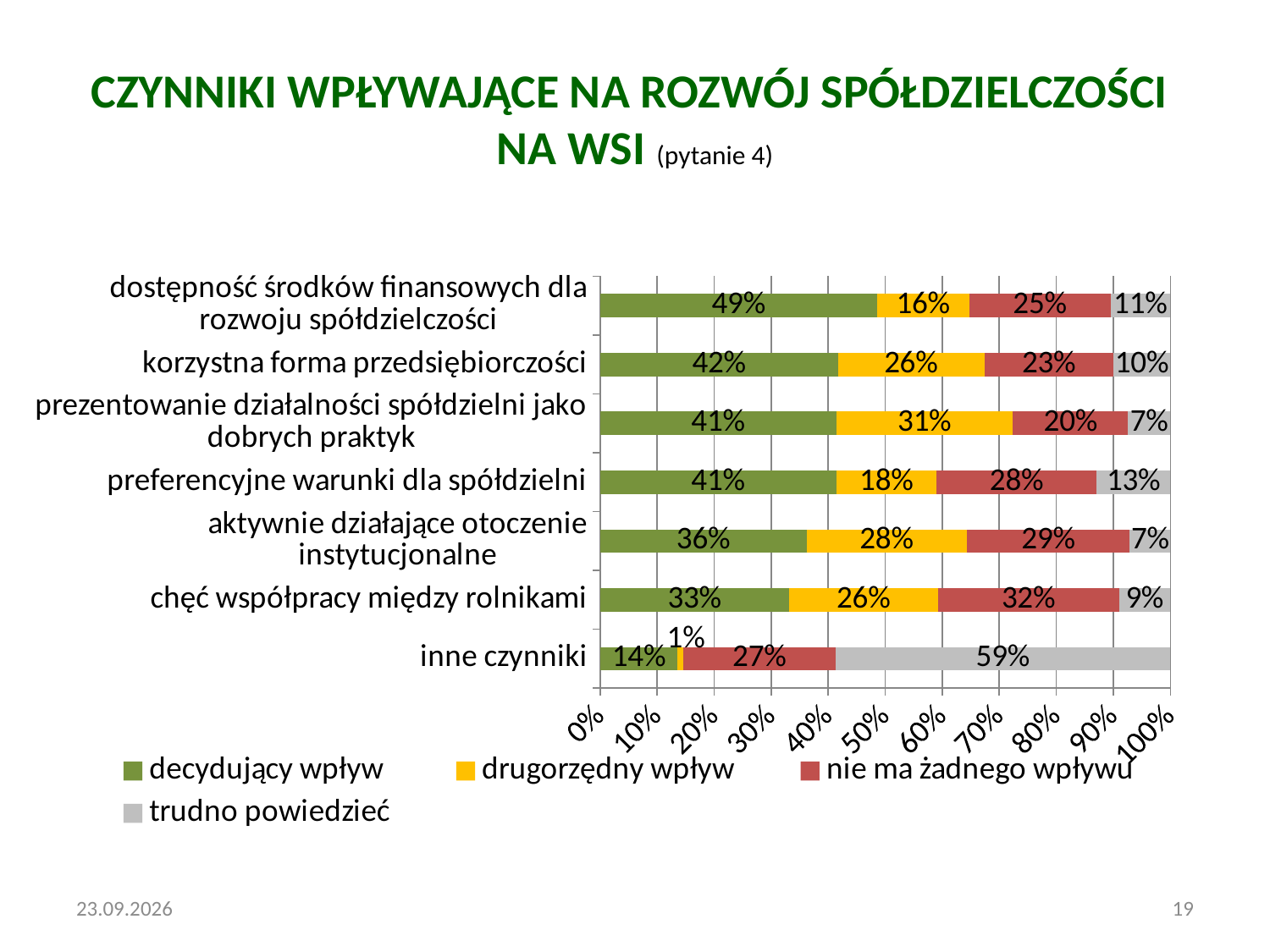
What kind of chart is shown on the slide? stacked bar chart Which category has the highest value for 'decydujący wpływ'? dostępność środków finansowych dla rozwoju spółdzielczości What is the value of 'nie ma żadnego wpływu' for 'chęć współpracy między rolnikami'? 32% What is the value of 'drugorzędny wpływ' for 'prezentowanie działalności spółdzielni jako dobrych praktyk'? 31% What is the difference between the 'decydujący wpływ' values for 'korzystna forma przedsiębiorczości' and 'chęć współpracy między rolnikami'? 9% How many categories (factors) are plotted on the chart? 7 How many series does the legend list? 4 Which category has the lowest value for 'drugorzędny wpływ'? inne czynniki Which is larger: the 'nie ma żadnego wpływu' value for 'preferencyjne warunki dla spółdzielni' or for 'korzystna forma przedsiębiorczości'? preferencyjne warunki dla spółdzielni What is the value of 'trudno powiedzieć' for 'inne czynniki'? 59% What is the value of 'decydujący wpływ' for 'dostępność środków finansowych dla rozwoju spółdzielczości'? 49% Which colour represents the series 'trudno powiedzieć' in the legend? grey